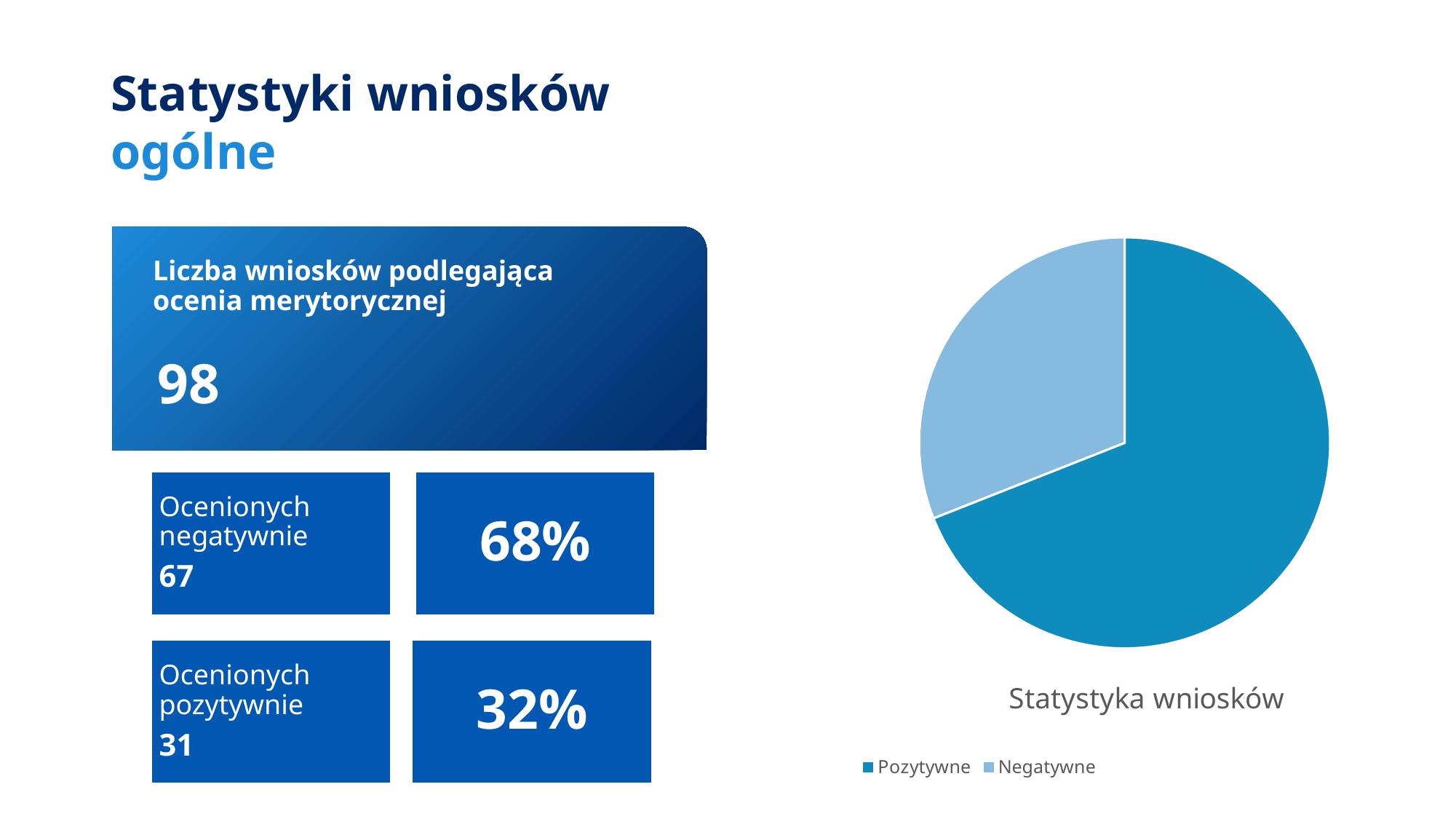
In the pie chart, which is larger, the Pozytywne slice or the Negatywne slice? Pozytywne What kind of chart is shown on the slide? pie chart Which slice of the pie chart is the smallest? Negatywne What is the title of the pie chart? Statystyka wniosków Which slice of the pie chart is the largest? Pozytywne How many entries does the pie chart's legend list? 2 Which legend entry of the pie chart is shown in the lighter blue colour? Negatywne How many slices does the pie chart have? 2